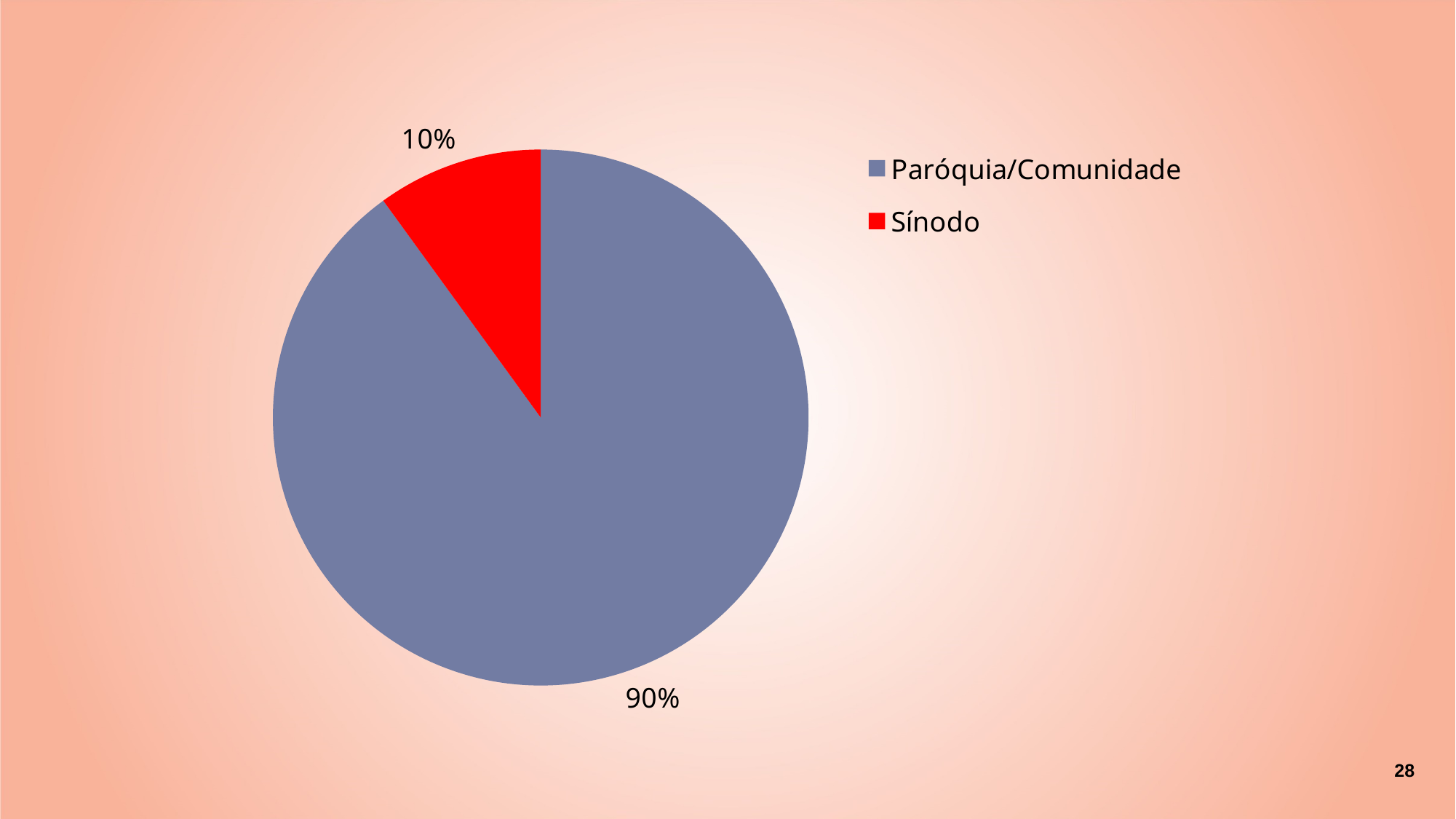
What kind of chart is shown on the slide? pie chart What colour is the Paróquia/Comunidade slice? blue-grey What colour is the Sínodo slice? red What share of the pie does Sínodo represent? 10% Which category has the largest slice of the pie? Paróquia/Comunidade Which category has the smallest slice of the pie? Sínodo How many entries does the legend list? 2 What is the difference in percentage points between the Paróquia/Comunidade slice and the Sínodo slice? 80 Which is larger, the Sínodo slice or the Paróquia/Comunidade slice? Paróquia/Comunidade What share of the pie does Paróquia/Comunidade represent? 90% How many slices does the pie chart have? 2